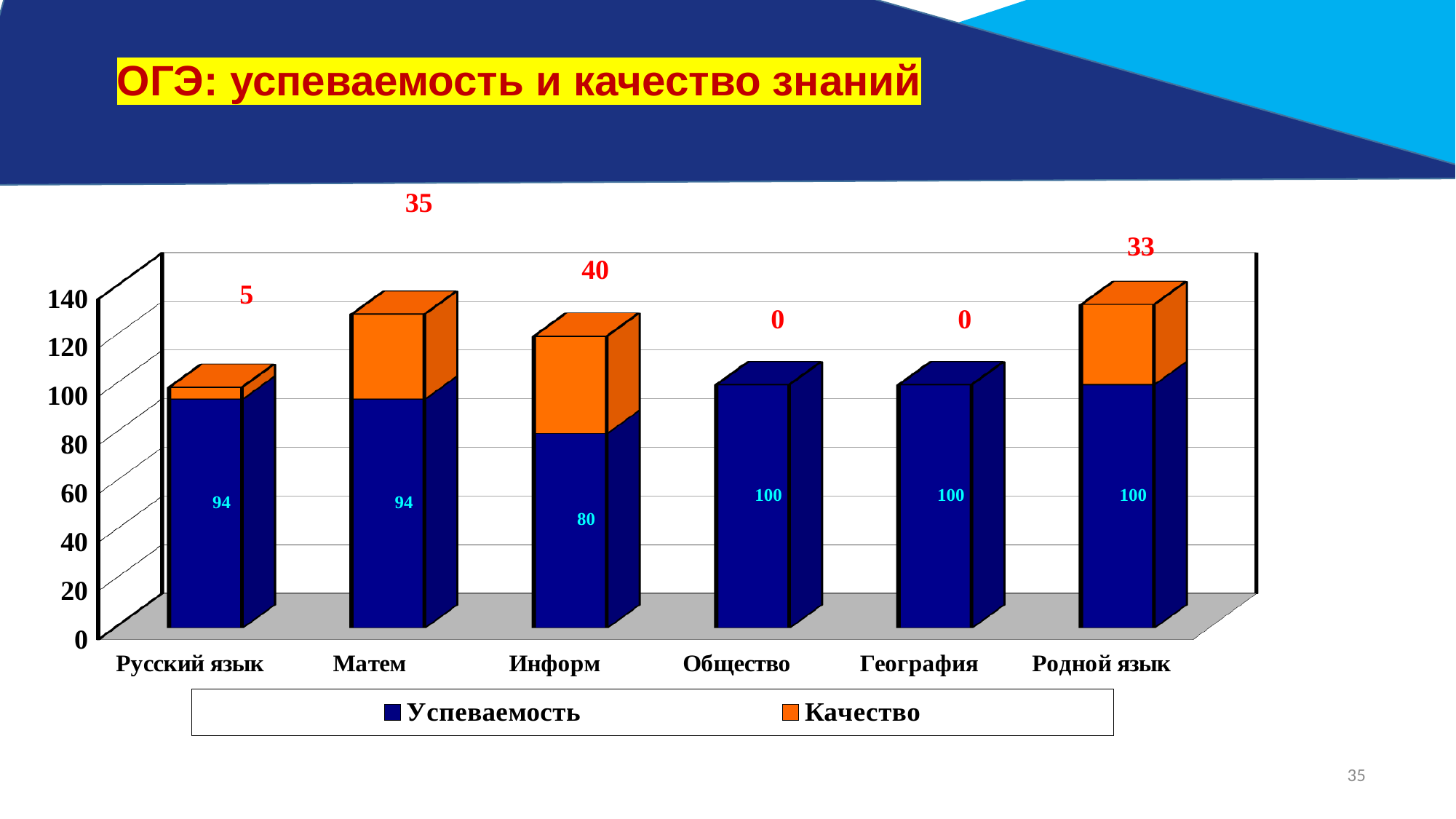
Which is larger, the Качество value for Родной язык or for Матем? Матем Which category has the highest Качество value? Информ What is the Успеваемость value for Информ? 80 What is the difference between the Качество values for Матем and Русский язык? 30 What is the Качество value for Матем? 35 What kind of chart is shown on the slide? Stacked bar chart What is the Качество value for Родной язык? 33 Which category has the lowest Успеваемость value? Информ What is the total of the stacked bar for Информ? 120 How many categories are shown on the x axis? 6 How many series does the legend list? 2 What is the Успеваемость value for Русский язык? 94